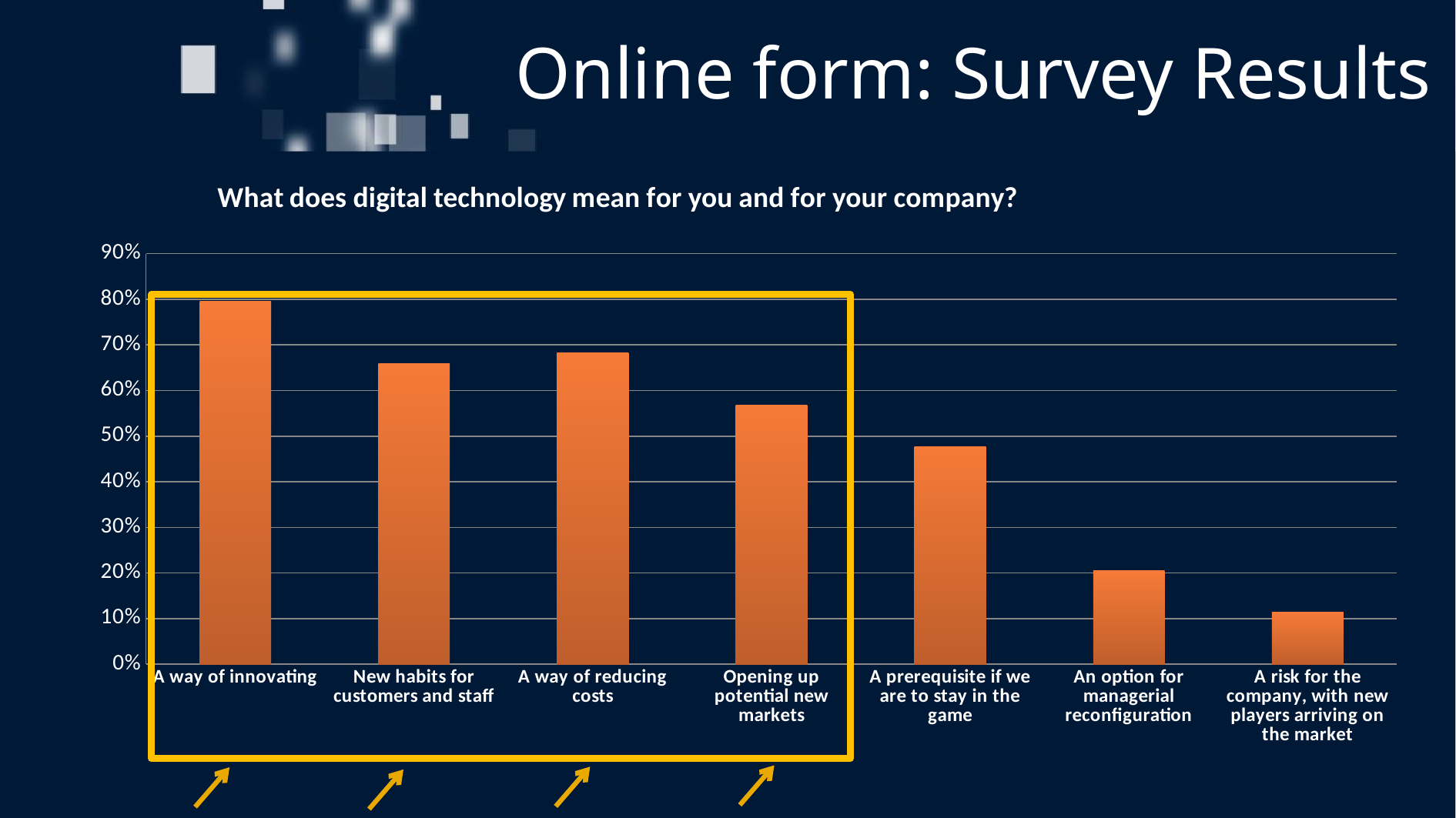
Is the value for 'A prerequisite if we are to stay in the game' greater or less than 40%? greater How many categories (bars) does the chart show? 7 What kind of chart is shown on the slide? bar chart Which category has the highest value? A way of innovating Is the value for 'Opening up potential new markets' greater or less than 50%? greater What question is the chart titled with? What does digital technology mean for you and for your company? Is the value for 'A risk for the company, with new players arriving on the market' greater or less than 20%? less Which category has the lowest value? A risk for the company, with new players arriving on the market Which is larger: the value for 'A way of innovating' or the value for 'Opening up potential new markets'? A way of innovating